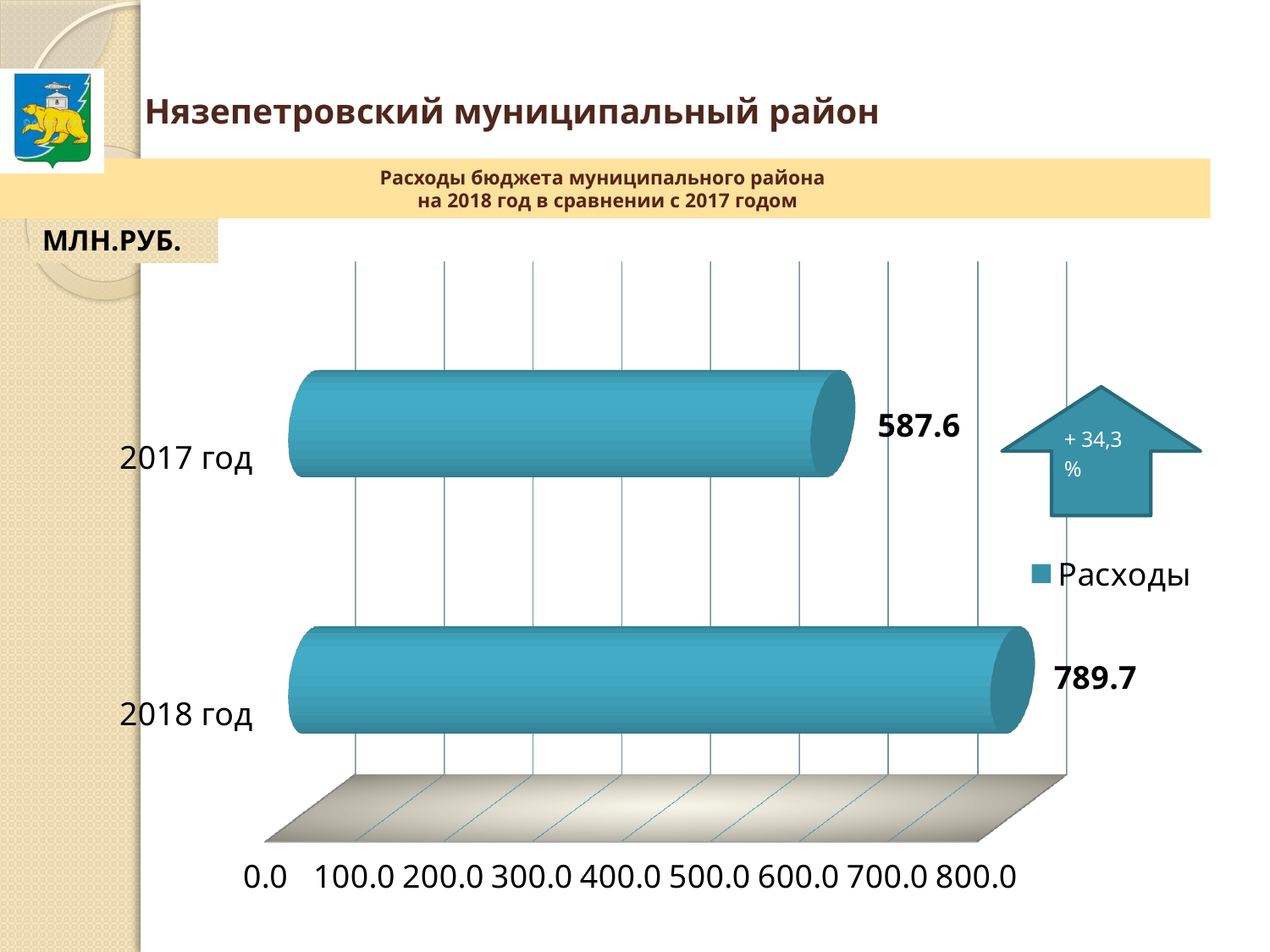
Which year has the lower expenditure value? 2017 год What is the value for 2017 год? 587.6 What is the value for 2018 год? 789.7 How many categories (years) are shown in the chart? 2 What is the name of the series shown in the legend? Расходы What kind of chart is shown on the slide? Bar chart How many series does the legend list? 1 Is the value for 2018 год greater or less than 700.0? greater Is the value for 2017 год greater or less than 600.0? less Which year has the higher expenditure value? 2018 год What is the difference between the 2018 год and 2017 год values? 202.1 Is the value for 2018 год larger than the value for 2017 год? Yes